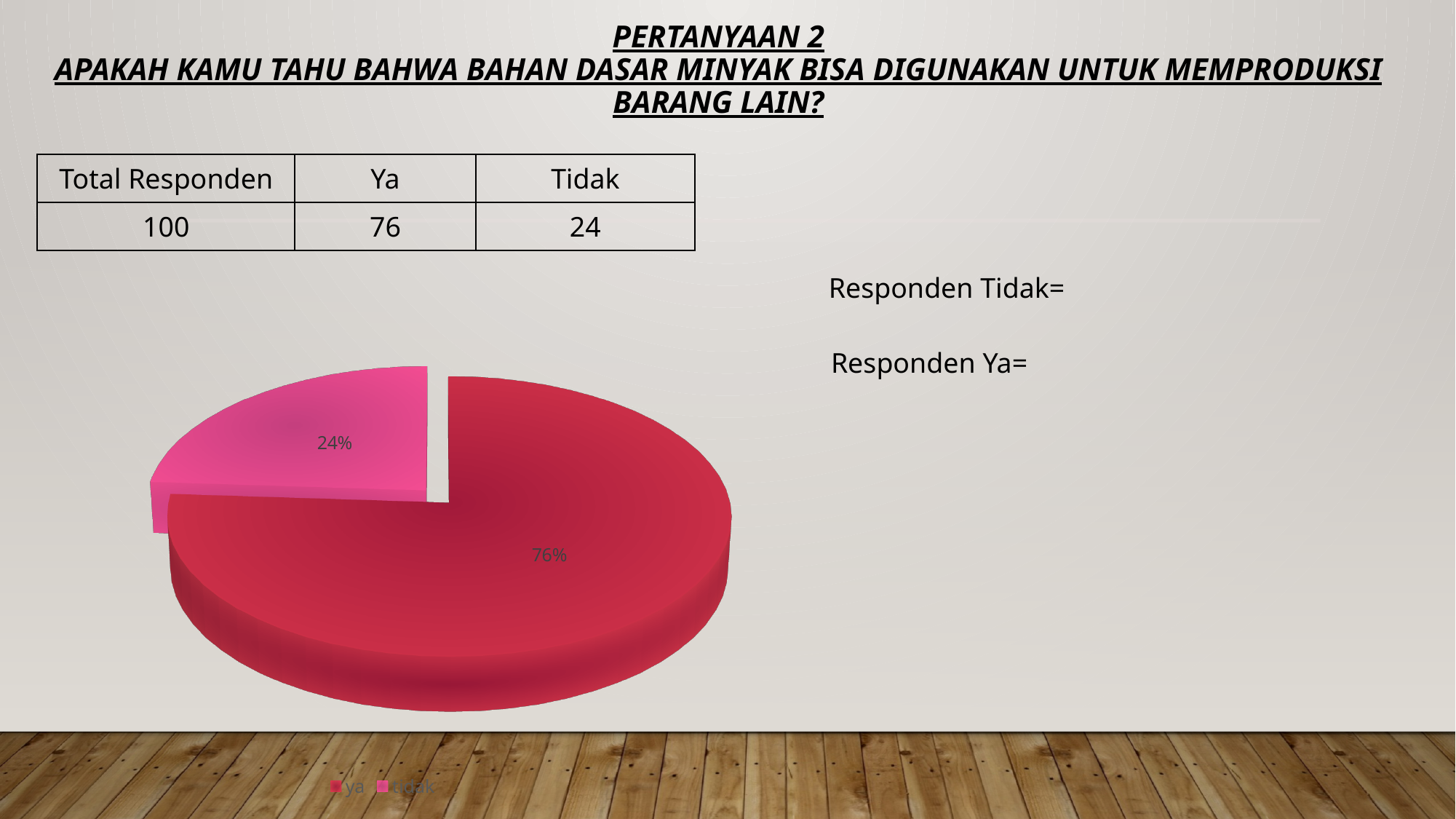
Which slice of the pie is the largest? ya How many entries does the legend list? 2 What colour is the "tidak" slice in the pie chart? pink How many slices does the pie chart have? 2 What share of the pie does the "ya" slice represent? 76% What is the difference in percentage points between the "ya" slice and the "tidak" slice? 52 percentage points Which slice of the pie is the smallest? tidak What share of the pie does the "tidak" slice represent? 24% Which slice is pulled out (exploded) from the pie? tidak Which is larger, the "ya" slice or the "tidak" slice? ya What kind of chart is shown on the slide? pie chart